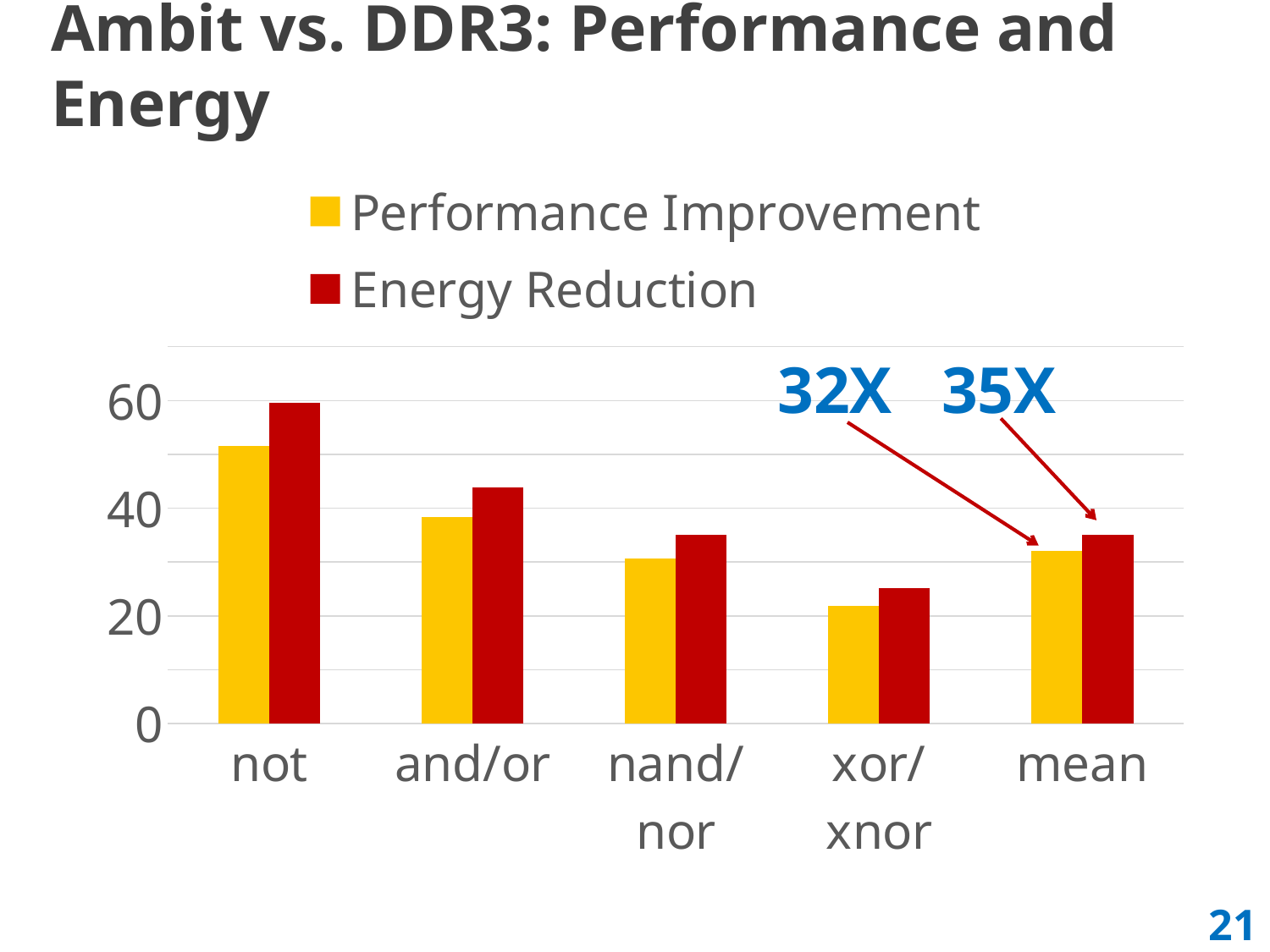
Is the Energy Reduction value for nand/nor greater or less than 40? less What is the Energy Reduction value for the mean category? 35X Which has a larger Performance Improvement: not or and/or? not How many categories are shown on the x axis? 5 What is the Performance Improvement value for the mean category? 32X Which category has the lowest Energy Reduction? xor/xnor Is the Performance Improvement value for xor/xnor greater or less than 40? less What kind of chart is shown on the slide? bar chart Is the Performance Improvement value for not greater or less than 40? greater For the not category, which is larger: Performance Improvement or Energy Reduction? Energy Reduction How many series does the legend list? 2 Which category has the highest Performance Improvement? not